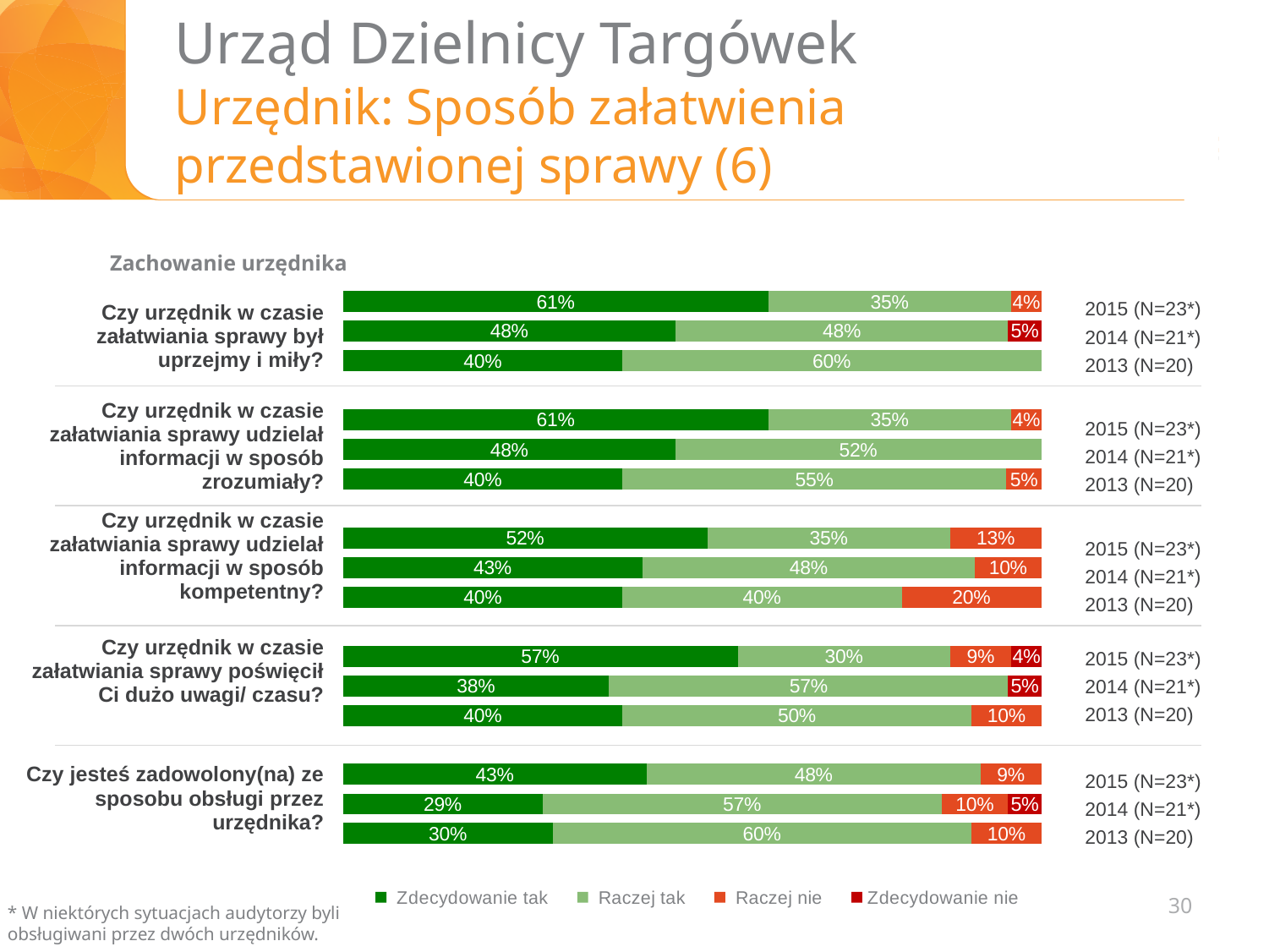
In the chart for "Czy urzędnik w czasie załatwiania sprawy udzielał informacji w sposób kompetentny?", what percentage answered "Raczej nie" in 2013 (N=20)? 20% In the chart for "Czy jesteś zadowolony(na) ze sposobu obsługi przez urzędnika?", what is the difference in percentage points between the "Zdecydowanie tak" share in 2015 (N=23*) and in 2013 (N=20)? 13 percentage points How many series does the legend at the bottom of the slide list? 4 In the chart for "Czy jesteś zadowolony(na) ze sposobu obsługi przez urzędnika?", what percentage answered "Raczej tak" in 2014 (N=21*)? 57% What kind of chart is used on this slide? Stacked bar chart In the chart for "Czy urzędnik w czasie załatwiania sprawy był uprzejmy i miły?", does the "Zdecydowanie tak" share rise or fall from 2013 to 2015? Rises In the chart for "Czy urzędnik w czasie załatwiania sprawy był uprzejmy i miły?", what percentage answered "Raczej tak" in 2013 (N=20)? 60% In the chart for "Czy urzędnik w czasie załatwiania sprawy udzielał informacji w sposób kompetentny?", which year has the highest "Zdecydowanie tak" share? 2015 (N=23*) In the chart for "Czy urzędnik w czasie załatwiania sprawy poświęcił Ci dużo uwagi/ czasu?", which year has the larger "Zdecydowanie tak" share: 2015 (N=23*) or 2014 (N=21*)? 2015 (N=23*) How many bars (years) are shown for each question on the slide? 3 What is the first entry in the legend at the bottom of the slide? Zdecydowanie tak In the chart for "Czy urzędnik w czasie załatwiania sprawy był uprzejmy i miły?", what percentage answered "Zdecydowanie tak" in 2015 (N=23*)? 61%